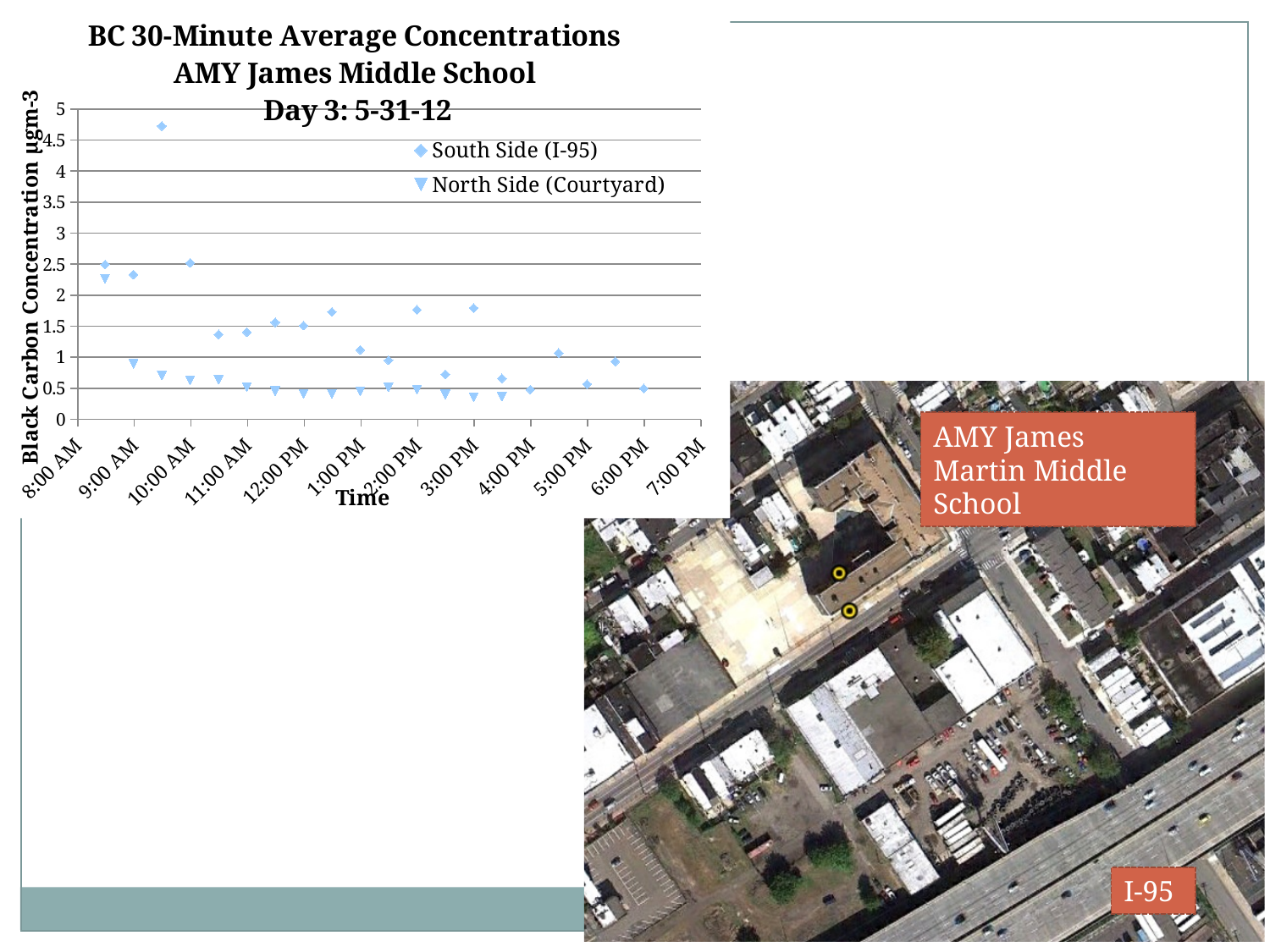
Is the North Side (Courtyard) value at 12:00 PM greater or less than 1? less What are the two series named in the chart legend? South Side (I-95) and North Side (Courtyard) What is the label of the chart's x axis? Time Is the highest South Side (I-95) value greater or less than 4? greater What kind of chart is shown on the slide? scatter chart Which series contains the highest plotted point on the chart? South Side (I-95) How many series does the chart legend list? 2 At 10:00 AM, which series has the larger value, South Side (I-95) or North Side (Courtyard)? South Side (I-95) Do the North Side (Courtyard) values generally rise or fall from 8:00 AM to 7:00 PM? fall How many time labels are shown along the x axis? 12